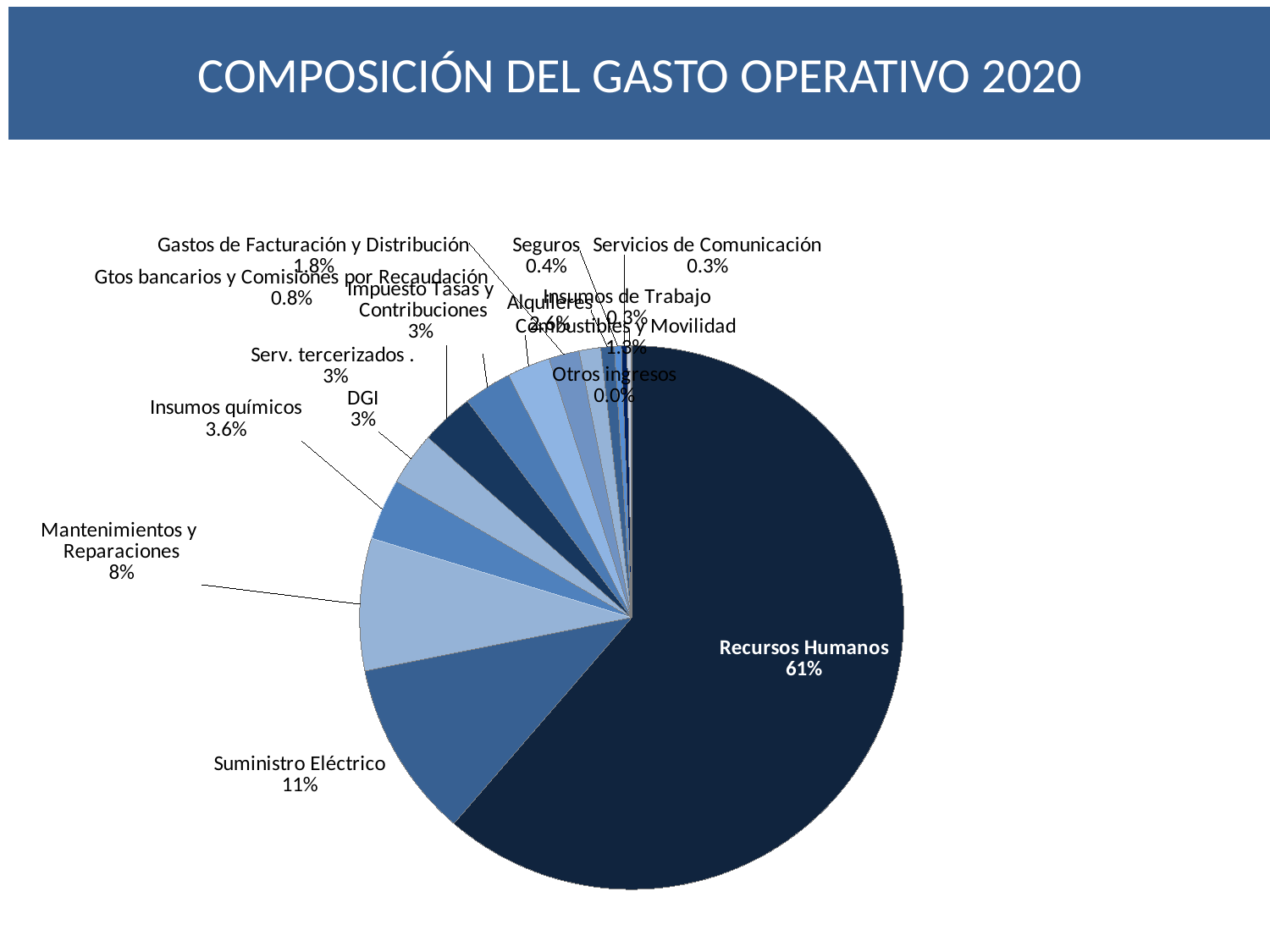
What is the title of the chart? COMPOSICIÓN DEL GASTO OPERATIVO 2020 Which is larger, Suministro Eléctrico or Mantenimientos y Reparaciones? Suministro Eléctrico What is the value shown for Gtos bancarios y Comisiones por Recaudación? 0.8% What is the value shown for Insumos químicos? 3.6% What is the value shown for Seguros? 0.4% What is the value shown for Mantenimientos y Reparaciones? 8% What is the difference between the shares of Recursos Humanos and Suministro Eléctrico? 50% Which category has the largest share of the pie? Recursos Humanos What is the value shown for Suministro Eléctrico? 11% What share of the pie does Recursos Humanos represent? 61% What is the value shown for Gastos de Facturación y Distribución? 1.8% What type of chart is shown on the slide? pie chart